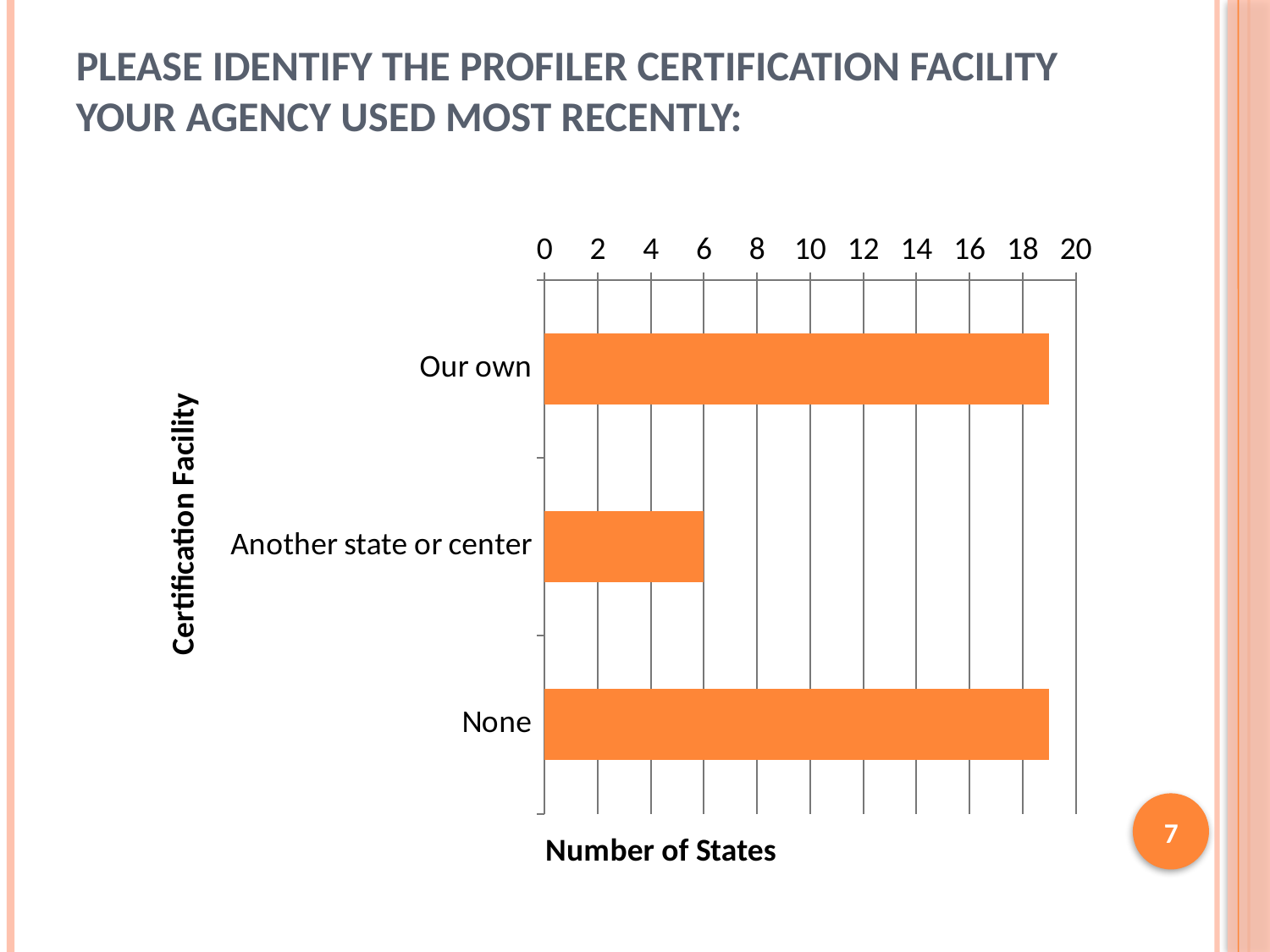
Is the value for "None" greater or less than 18? greater Is the value for "Another state or center" greater or less than 10? less Which certification facility category has the lowest number of states? Another state or center Which has more states, "Our own" or "Another state or center"? Our own Is the value for "Our own" greater or less than 10? greater What is the title of the vertical axis of the chart? Certification Facility What is the title of the horizontal axis of the chart? Number of States What is the number of states for "Another state or center"? 6 How many certification facility categories are plotted in the chart? 3 Which has more states, "None" or "Another state or center"? None What kind of chart is shown on the slide? bar chart